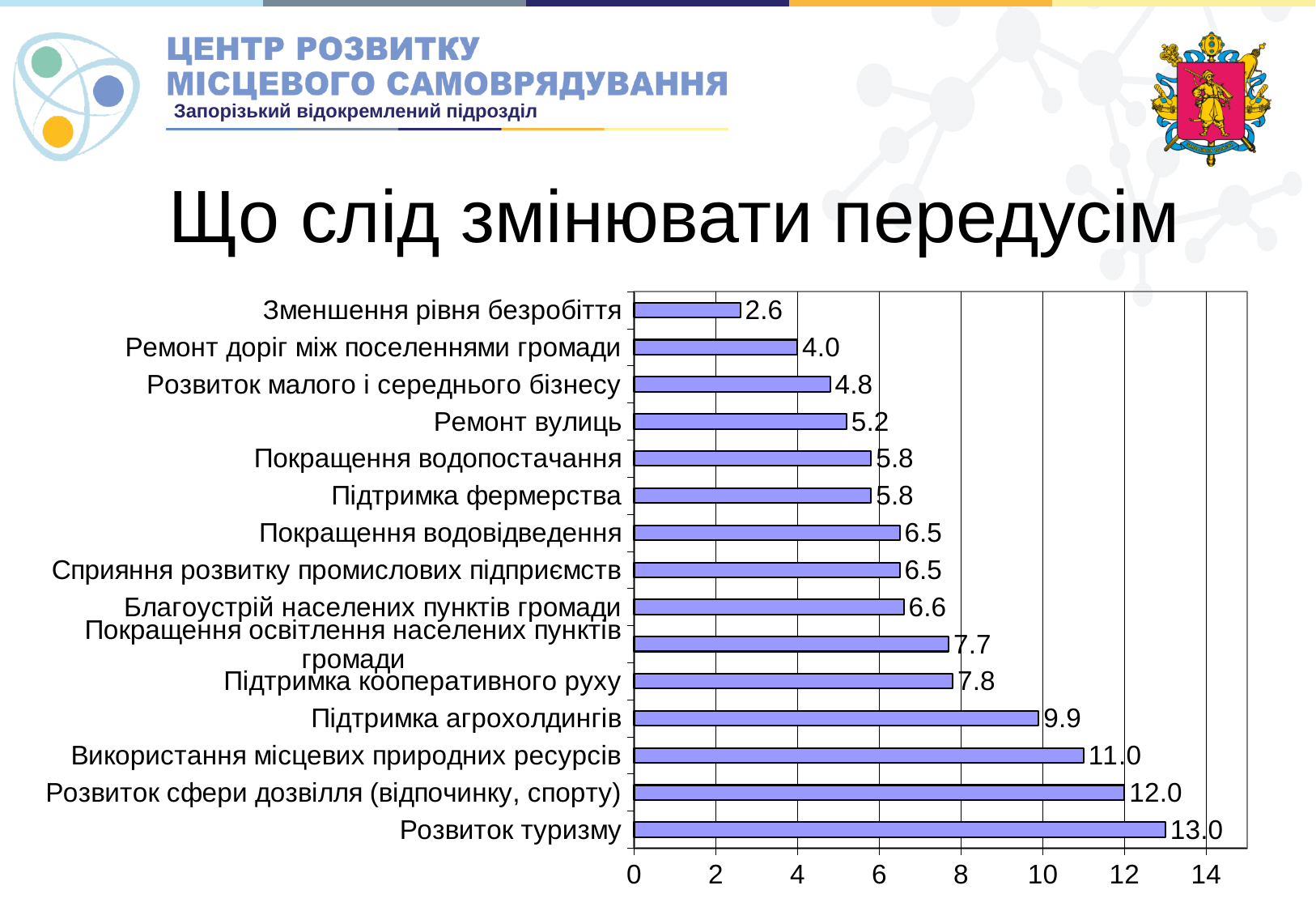
What value is shown for "Підтримка агрохолдингів"? 9.9 What value is shown for "Ремонт вулиць"? 5.2 What kind of chart is shown on the slide? bar chart How many categories are shown in the chart? 15 Is the value for "Розвиток сфери дозвілля (відпочинку, спорту)" greater or less than 10? greater What is the title of the slide? Що слід змінювати передусім What value is shown for "Розвиток туризму"? 13.0 What is the difference between the values for "Використання місцевих природних ресурсів" and "Підтримка агрохолдингів"? 1.1 What is the difference between the values for "Розвиток туризму" and "Зменшення рівня безробіття"? 10.4 Which category has the lowest value? Зменшення рівня безробіття Which category has the highest value? Розвиток туризму Which is larger: the value for "Ремонт доріг між поселеннями громади" or the value for "Розвиток малого і середнього бізнесу"? Розвиток малого і середнього бізнесу